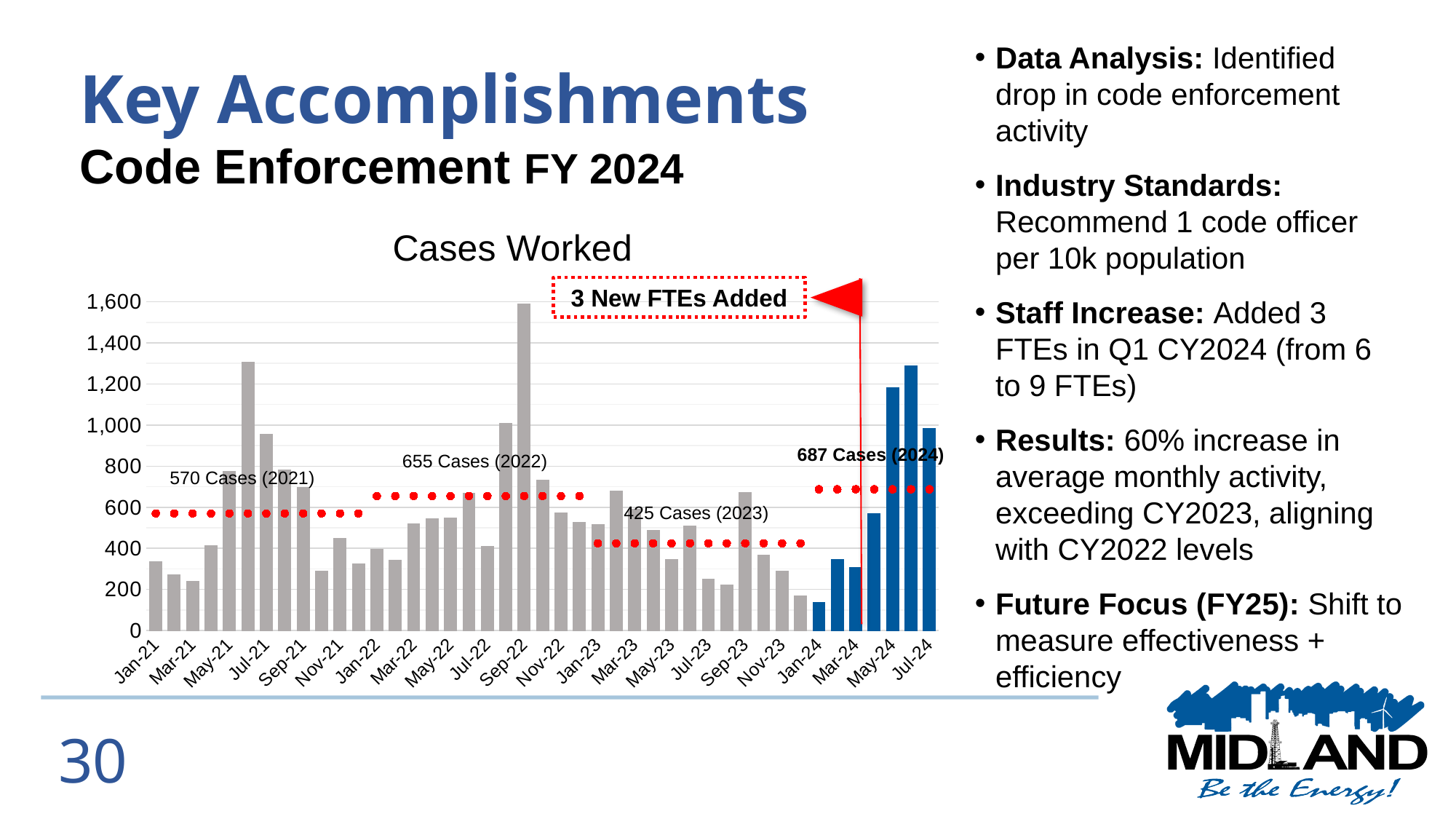
Is the value for Sep-22 greater or less than 1,400? greater Which is larger, the value for Jun-24 or the value for May-24? Jun-24 What is the title of the chart? Cases Worked What does the red dotted callout box on the chart say? 3 New FTEs Added What average case count is annotated for 2021 on the chart? 570 Cases (2021) What type of chart is shown on the slide? bar chart Is the value for Jan-24 greater or less than 200? less Is the value for May-24 greater or less than 1,000? greater Which month has the highest bar in the chart? Sep-22 What average case count is annotated for 2024 on the chart? 687 Cases (2024) What is the difference between the annotated 2024 average (687) and the 2023 average (425)? 262 What average case count is annotated for 2023 on the chart? 425 Cases (2023)